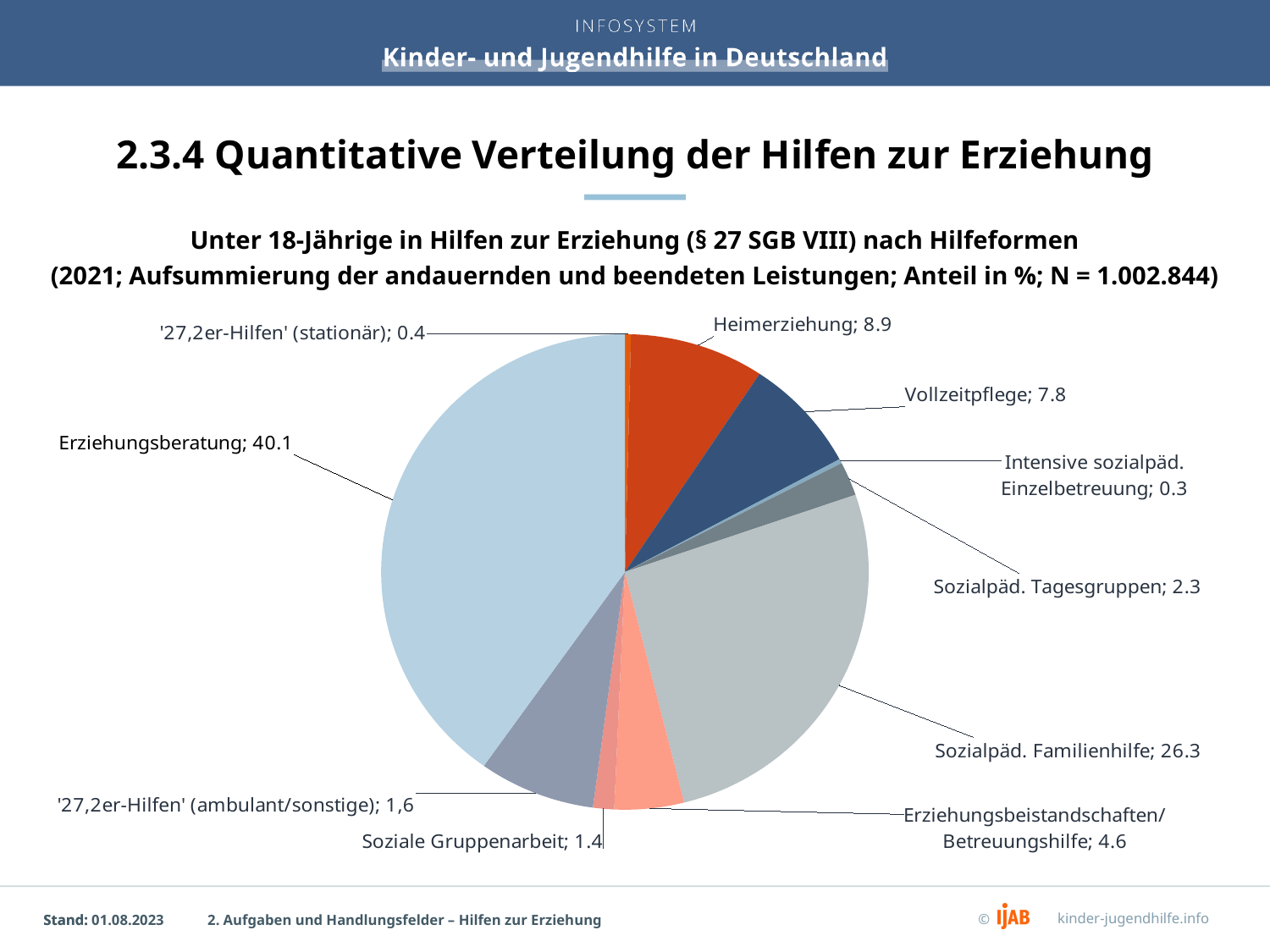
What is the N value stated in the chart title? 1.002.844 What kind of chart is shown on the slide? pie chart How many categories are shown in the pie chart? 10 What share of the pie does Sozialpäd. Tagesgruppen represent? 2.3 Which is larger, the value for Heimerziehung or the value for Vollzeitpflege? Heimerziehung What value is shown for Erziehungsberatung? 40.1 What is the difference between the values for Erziehungsberatung and Sozialpäd. Familienhilfe? 13.8 Which category has the largest slice of the pie? Erziehungsberatung What value is shown for Heimerziehung? 8.9 What value is shown for Erziehungsbeistandschaften/Betreuungshilfe? 4.6 What value is shown for Sozialpäd. Familienhilfe? 26.3 Which category has the smallest slice of the pie? Intensive sozialpäd. Einzelbetreuung